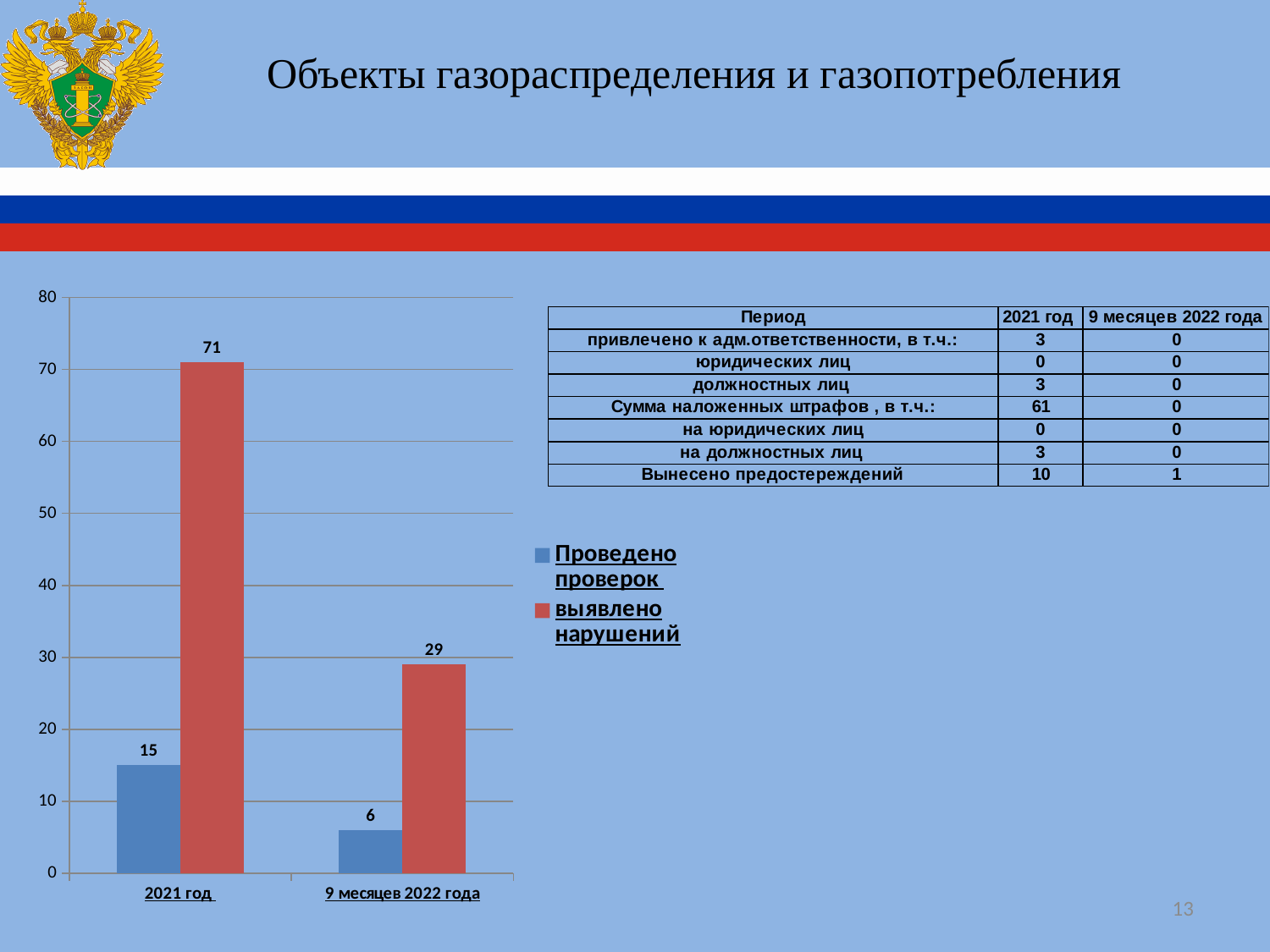
What is the value of "выявлено нарушений" for "2021 год"? 71 Which category has the lowest value for "Проведено проверок"? 9 месяцев 2022 года How many series does the chart legend list? 2 What is the value of "Проведено проверок" for "9 месяцев 2022 года"? 6 What is the value of "выявлено нарушений" for "9 месяцев 2022 года"? 29 Do the values of "Проведено проверок" rise or fall from "2021 год" to "9 месяцев 2022 года"? fall What is the difference between "выявлено нарушений" for "2021 год" and for "9 месяцев 2022 года"? 42 What type of chart is shown on the slide? bar chart What is the value of "Проведено проверок" for "2021 год"? 15 Which category has the highest value for "выявлено нарушений"? 2021 год Which is larger: "Проведено проверок" for "2021 год" or "выявлено нарушений" for "9 месяцев 2022 года"? выявлено нарушений for 9 месяцев 2022 года How many categories are shown on the x axis of the chart? 2